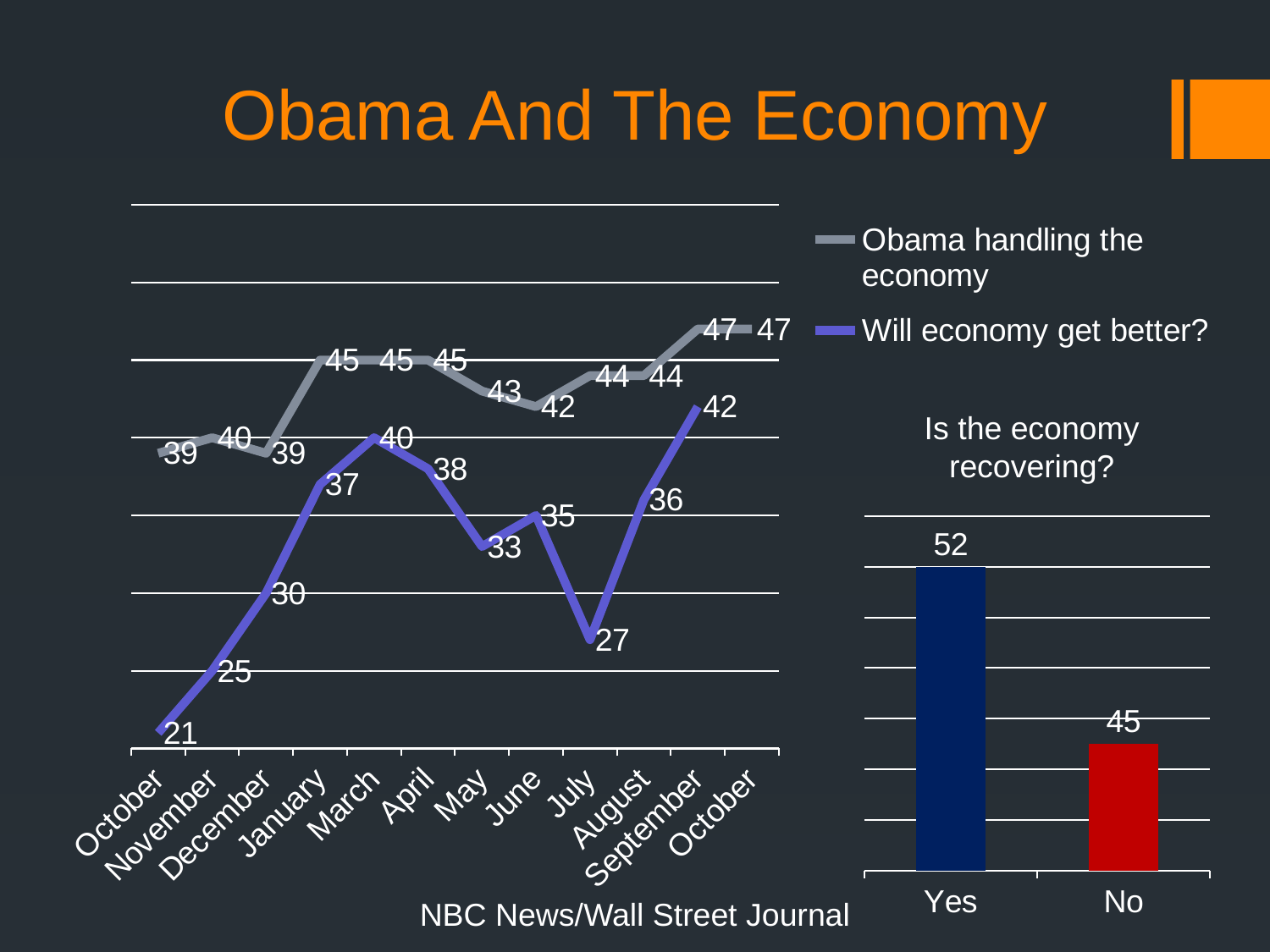
In the line chart on the left, what is the lowest value on the 'Will economy get better?' line? 21 What kind of chart is the 'Is the economy recovering?' chart on the right of the slide? bar chart In the line chart on the left, what is the value of 'Will economy get better?' for January? 37 How many series does the legend of the line chart on the left list? 2 In the 'Is the economy recovering?' chart, what is the value for Yes? 52 In the 'Is the economy recovering?' chart, what is the value for No? 45 In the line chart on the left, does the 'Obama handling the economy' line overall rise or fall from the first October to the last October? rise In the 'Is the economy recovering?' chart, what is the difference between the Yes and No values? 7 In the line chart on the left, what is the highest value reached by the 'Obama handling the economy' line? 47 In the line chart on the left, what is the value of 'Obama handling the economy' for January? 45 In the line chart on the left, what is the value of 'Will economy get better?' for July? 27 In the 'Is the economy recovering?' chart, which bar is taller, Yes or No? Yes